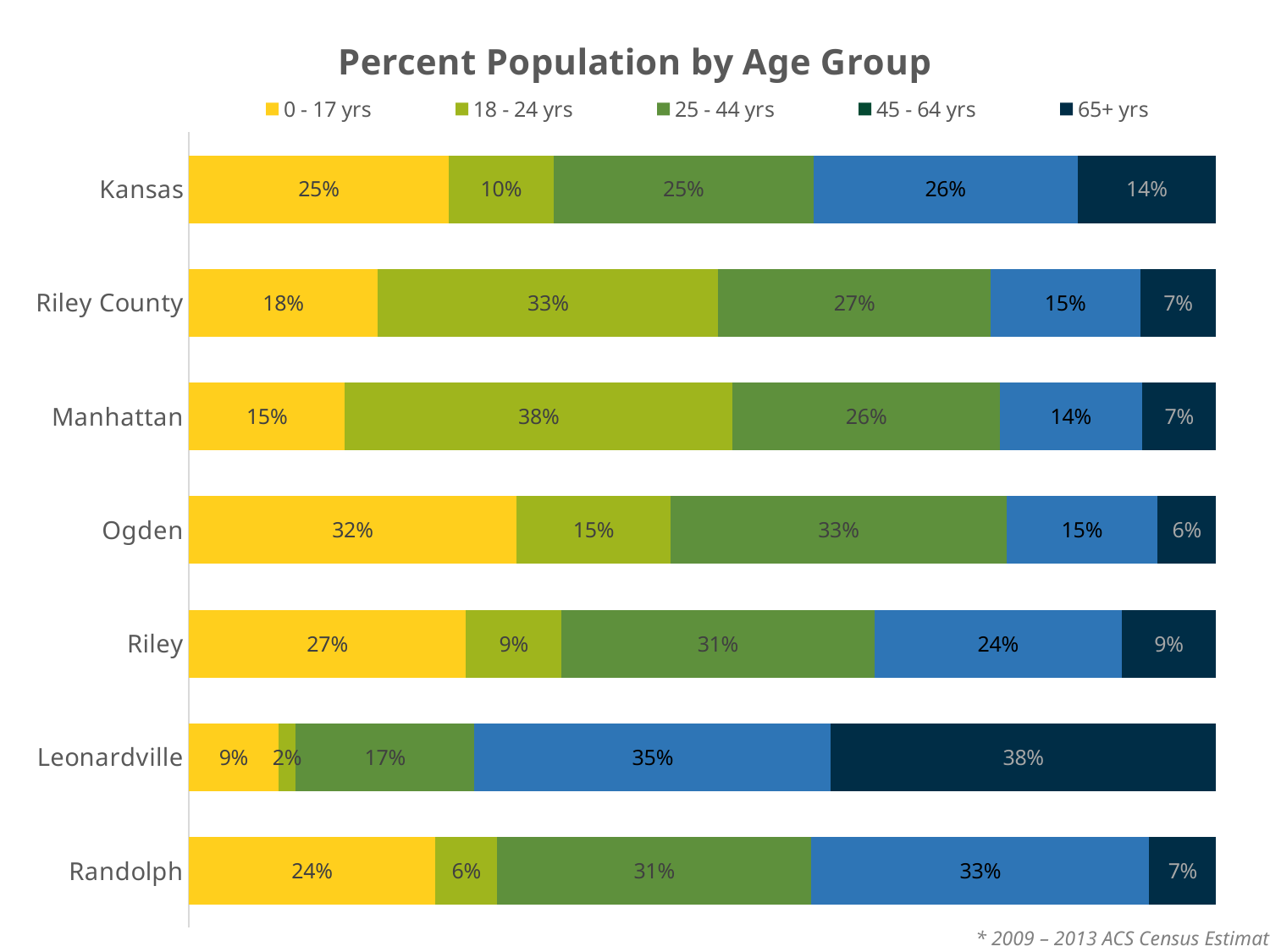
Which has a larger 25 - 44 yrs share, Riley or Ogden? Ogden What kind of chart is shown on the slide? Stacked bar chart What percentage of Manhattan's population is in the 18 - 24 yrs age group? 38% What is the total of all segments in the Kansas bar? 100% Which area has the lowest percentage in the 18 - 24 yrs age group? Leonardville How many percentage points higher is the 45 - 64 yrs value for Kansas than for Riley County? 11 How many areas are shown on the chart? 7 What is the value for the 45 - 64 yrs segment for Randolph? 33% What is the title of the chart? Percent Population by Age Group How many age groups does the legend list? 5 What is the value for the 65+ yrs segment for Leonardville? 38% Which area has the highest percentage in the 0 - 17 yrs age group? Ogden